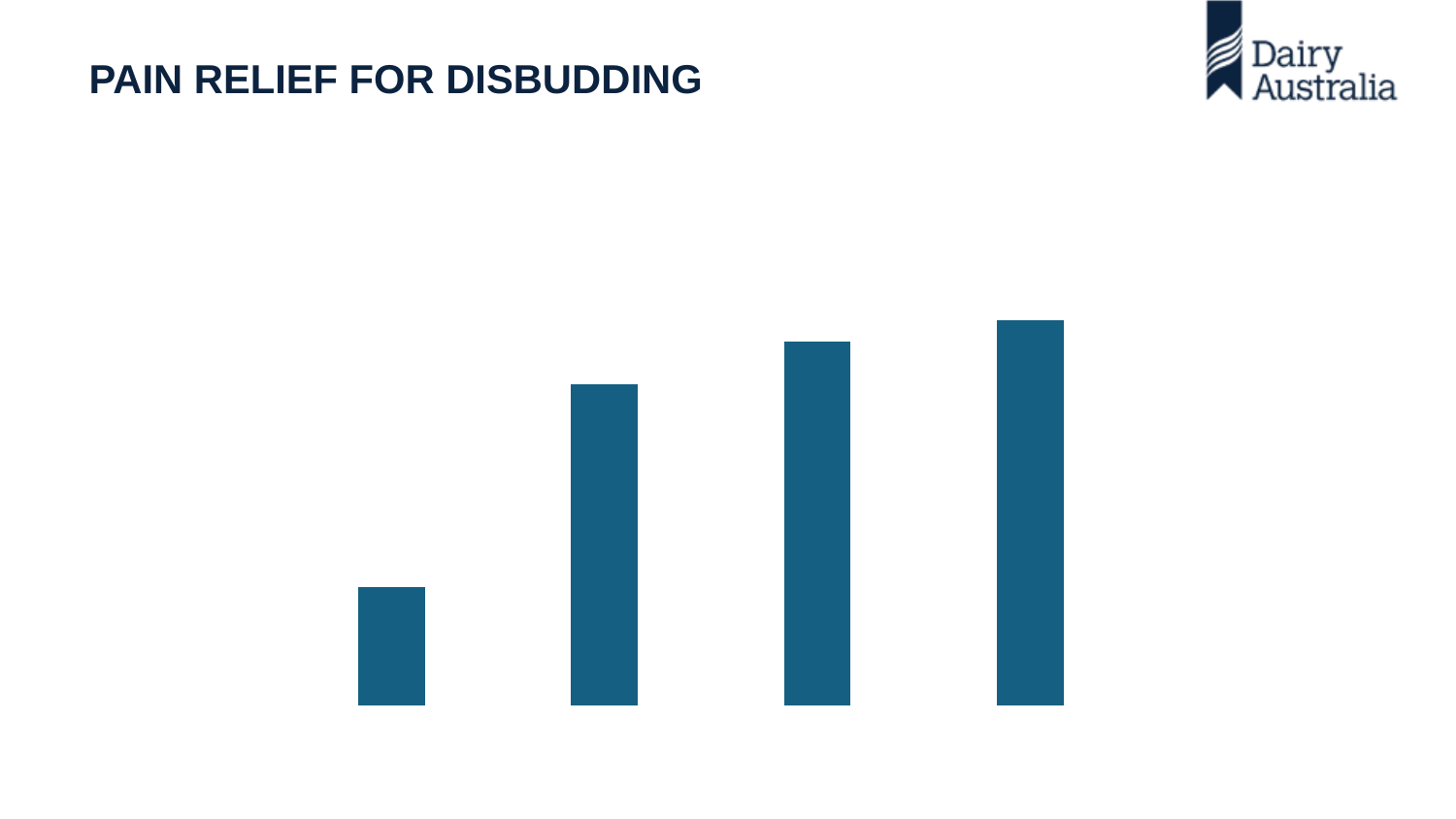
Which bar is the shortest: the first, second, third or fourth from the left? first What colour are the bars in the chart? dark blue Which is taller, the second bar from the left or the third bar from the left? the third bar Which is taller, the first bar from the left or the second bar from the left? the second bar How many bars does the chart show? 4 What kind of chart is shown on the slide? bar chart Do the bar values rise or fall from left to right across the chart? rise What is the title shown at the top of the slide above the chart? PAIN RELIEF FOR DISBUDDING Which bar is the tallest: the first, second, third or fourth from the left? fourth